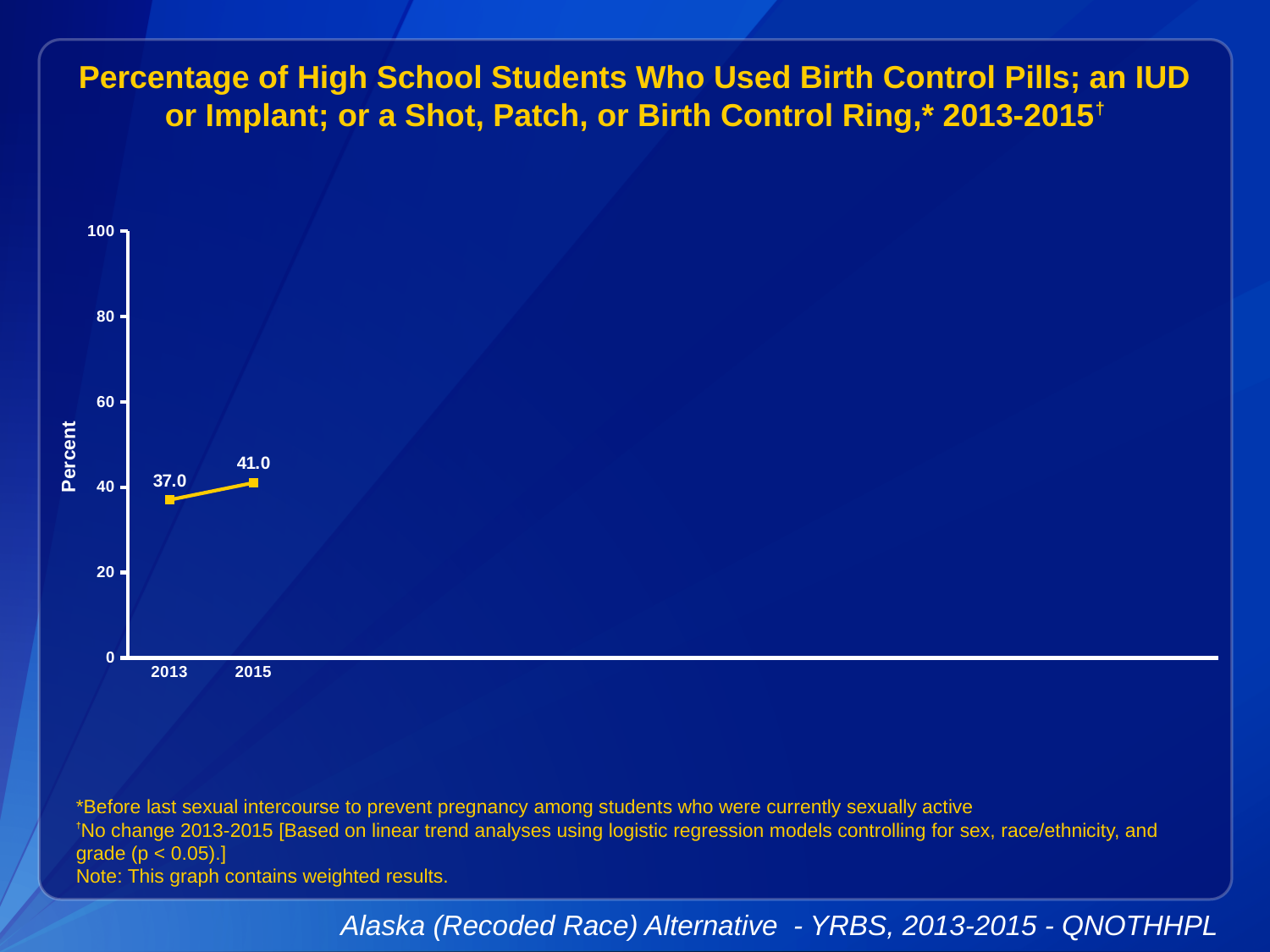
Do the values rise or fall from 2013 to 2015? rise Which is larger, the value for 2013 or the value for 2015? 2015 What kind of chart is shown on the slide? line chart Which year has the highest value? 2015 What is the difference between the values for 2015 and 2013? 4.0 What is the value for 2013? 37.0 Is the value for 2015 greater or less than 60? less Is the value for 2013 greater or less than 20? greater What is the value for 2015? 41.0 What is the label on the y axis? Percent How many data points are plotted on the chart? 2 Which year has the lowest value? 2013